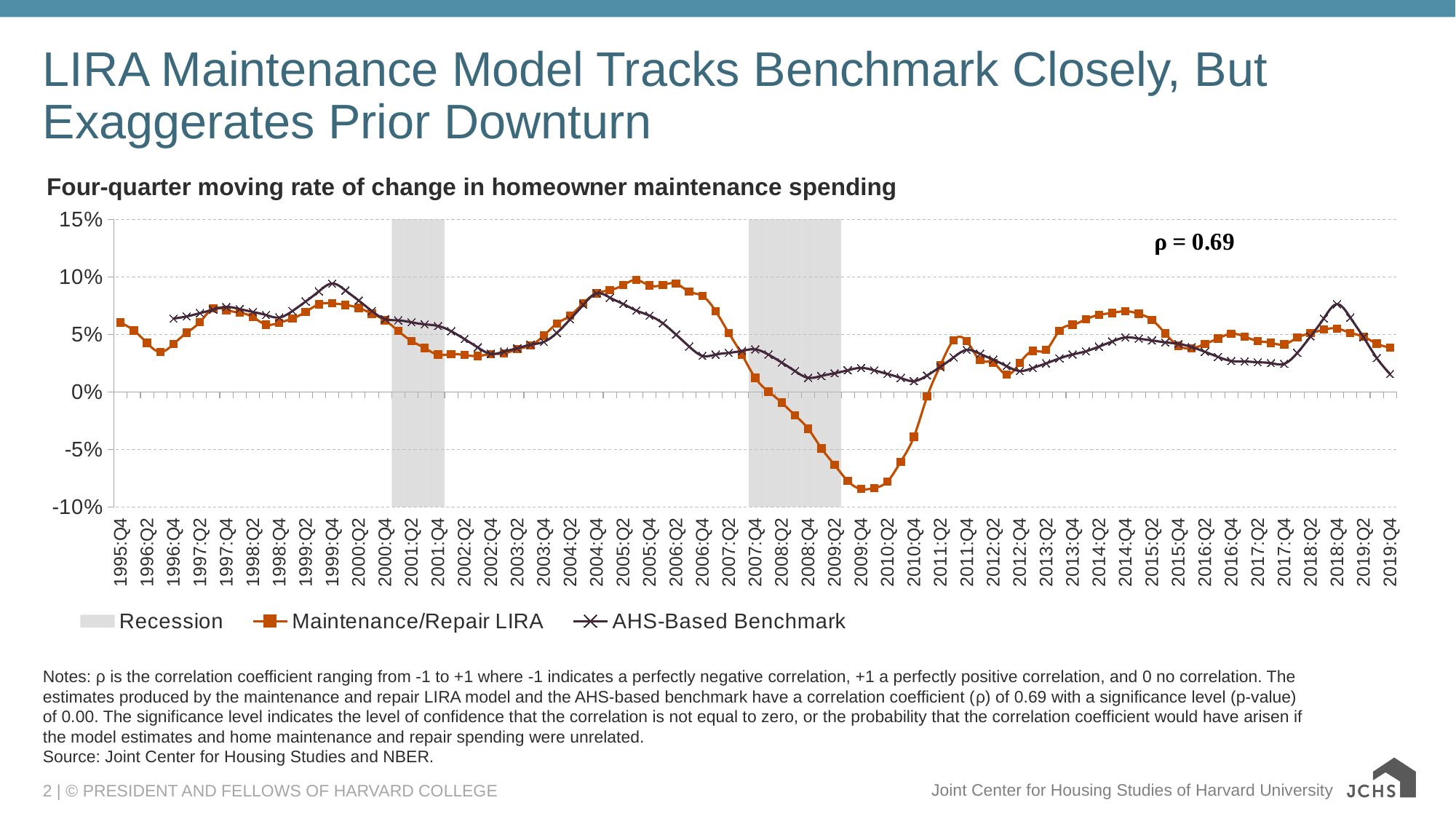
Is the AHS-Based Benchmark value at 2018:Q4 greater or less than 5%? greater At 2005:Q2, which series has the higher value, Maintenance/Repair LIRA or AHS-Based Benchmark? Maintenance/Repair LIRA Is the Maintenance/Repair LIRA value at 2005:Q2 greater or less than 5%? greater At 2009:Q4, which series has the higher value, Maintenance/Repair LIRA or AHS-Based Benchmark? AHS-Based Benchmark How many entries does the chart legend list? 3 Is the Maintenance/Repair LIRA value at 2009:Q4 greater or less than -5%? less What is the subtitle describing the measure plotted in the chart? Four-quarter moving rate of change in homeowner maintenance spending What kind of chart is shown on the slide? Line chart How many shaded recession periods are shown on the chart? 2 Does the Maintenance/Repair LIRA series rise or fall between 2007:Q2 and 2009:Q4? Fall What correlation coefficient (ρ) is printed on the chart? ρ = 0.69